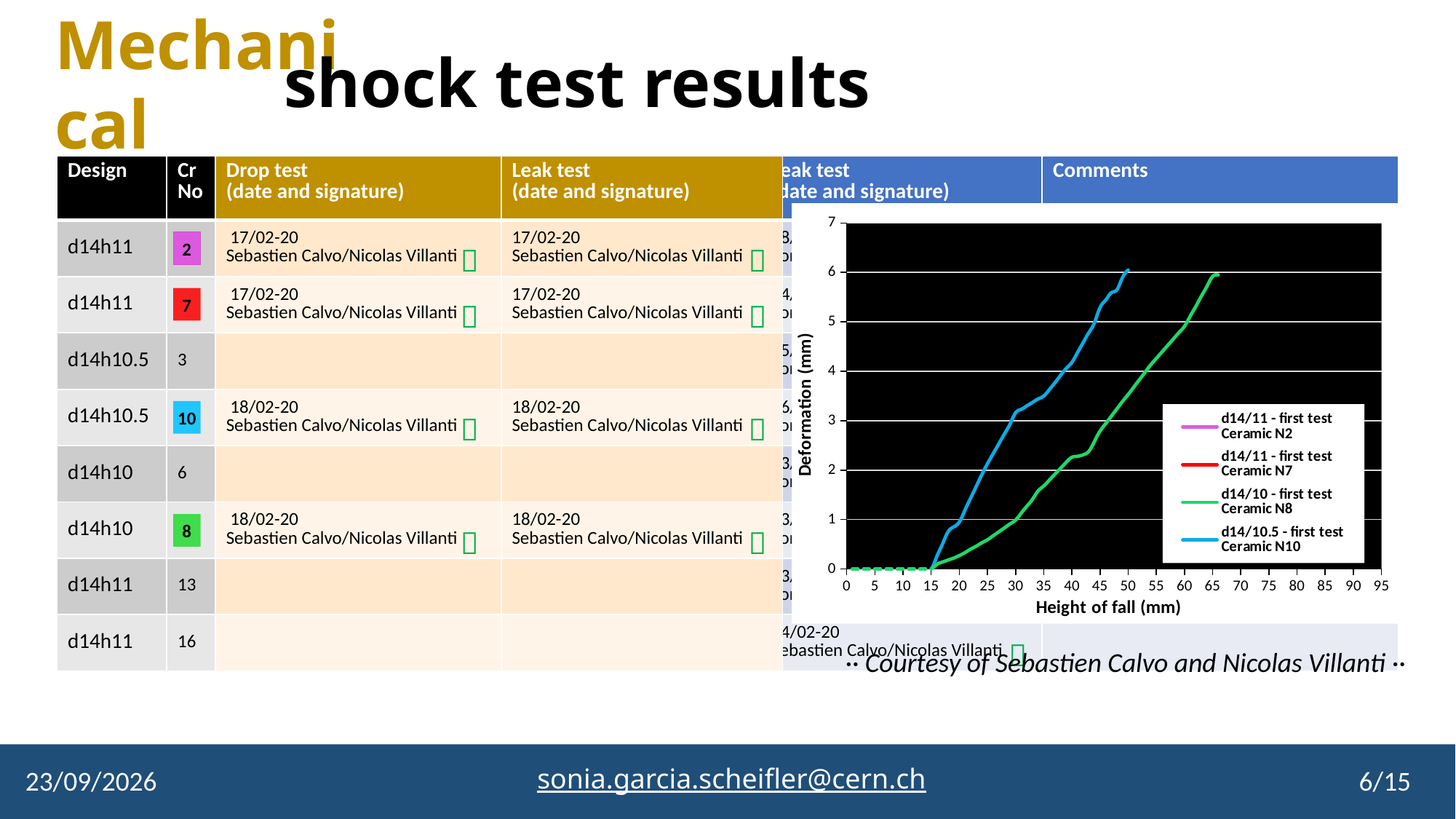
Does the deformation for d14/10.5 - first test Ceramic N10 rise or fall as the height of fall increases beyond 15 mm? rise What is the title of the y axis of the chart? Deformation (mm) What is the highest value shown on the y axis of the chart? 7 Is the deformation for d14/10.5 - first test Ceramic N10 at a height of fall of 50 mm greater or less than 5? greater How many series does the chart legend list? 4 What is the title of the x axis of the chart? Height of fall (mm) At a height of fall of 40 mm, which series shows the larger deformation: d14/10.5 - first test Ceramic N10 or d14/10 - first test Ceramic N8? d14/10.5 - first test Ceramic N10 Is the deformation for d14/10 - first test Ceramic N8 at a height of fall of 20 mm greater or less than 1? less Which series extends to the greatest height of fall on the chart? d14/10 - first test Ceramic N8 Is the deformation for d14/10 - first test Ceramic N8 at a height of fall of 65 mm greater or less than 5? greater What kind of chart is shown on the slide? line chart